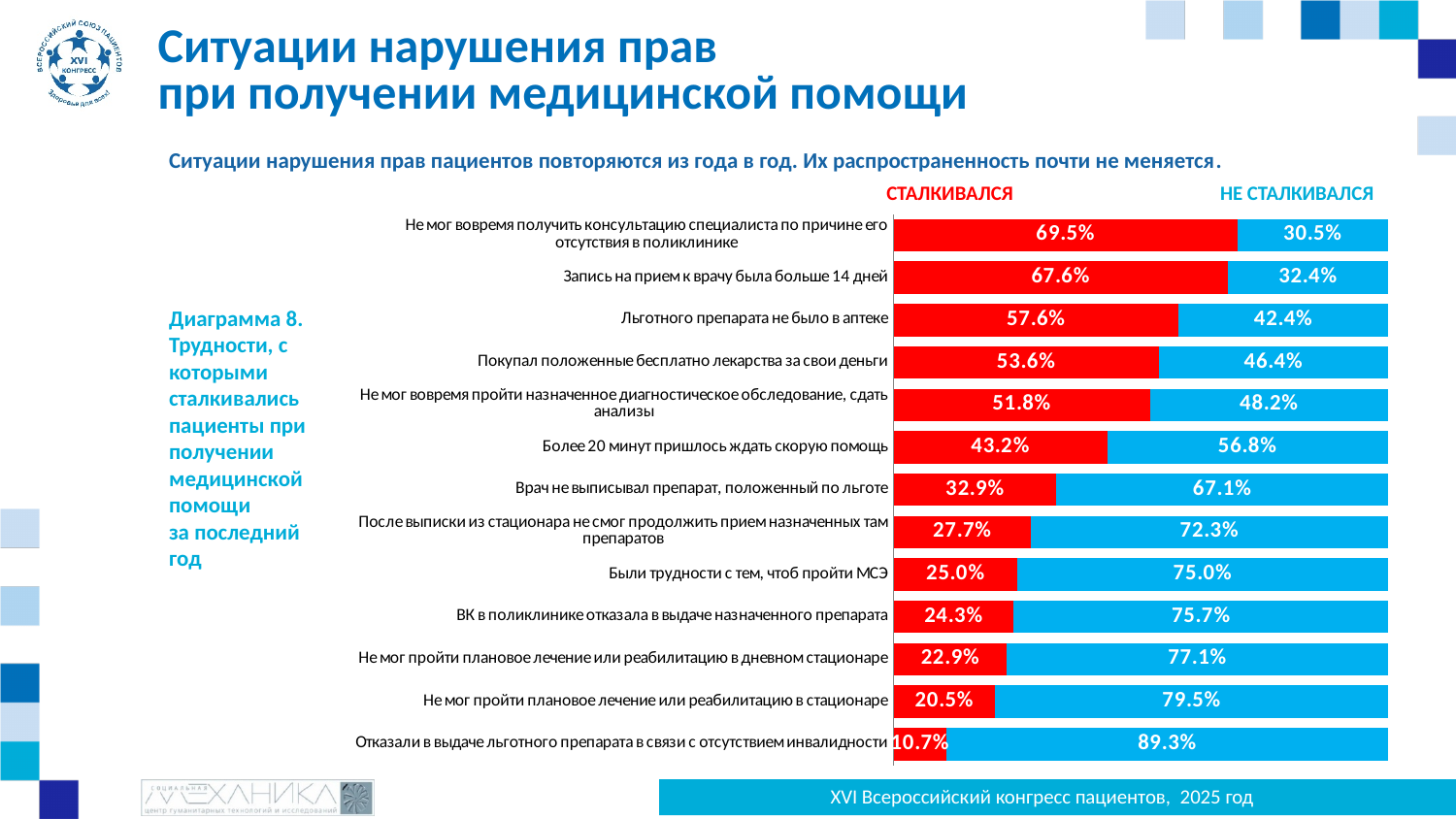
Какая доля больше: сталкивавшихся с ситуацией «Врач не выписывал препарат, положенный по льготе» или «После выписки из стационара не смог продолжить прием назначенных там препаратов»? Врач не выписывал препарат, положенный по льготе Какая доля пациентов сталкивалась с ситуацией «Были трудности с тем, чтоб пройти МСЭ»? 25.0% Какая доля пациентов сталкивалась с ситуацией «Запись на прием к врачу была больше 14 дней»? 67.6% Сколько рядов данных указано в легенде диаграммы? 2 Чему равна сумма долей «Сталкивался» и «Не сталкивался» для ситуации «Покупал положенные бесплатно лекарства за свои деньги»? 100% Какая доля пациентов не сталкивалась с ситуацией «Более 20 минут пришлось ждать скорую помощь»? 56.8% С какой ситуацией сталкивалась наименьшая доля пациентов? Отказали в выдаче льготного препарата в связи с отсутствием инвалидности Какой тип диаграммы показан на слайде? Столбчатая (линейчатая) диаграмма с накоплением Сколько категорий (ситуаций) показано на диаграмме? 13 На сколько процентных пунктов доля столкнувшихся с ситуацией «Льготного препарата не было в аптеке» больше, чем с ситуацией «Более 20 минут пришлось ждать скорую помощь»? 14.4 Каким цветом на диаграмме показан ряд «НЕ СТАЛКИВАЛСЯ»? Голубым (синим) С какой ситуацией сталкивалась наибольшая доля пациентов? Не мог вовремя получить консультацию специалиста по причине его отсутствия в поликлинике